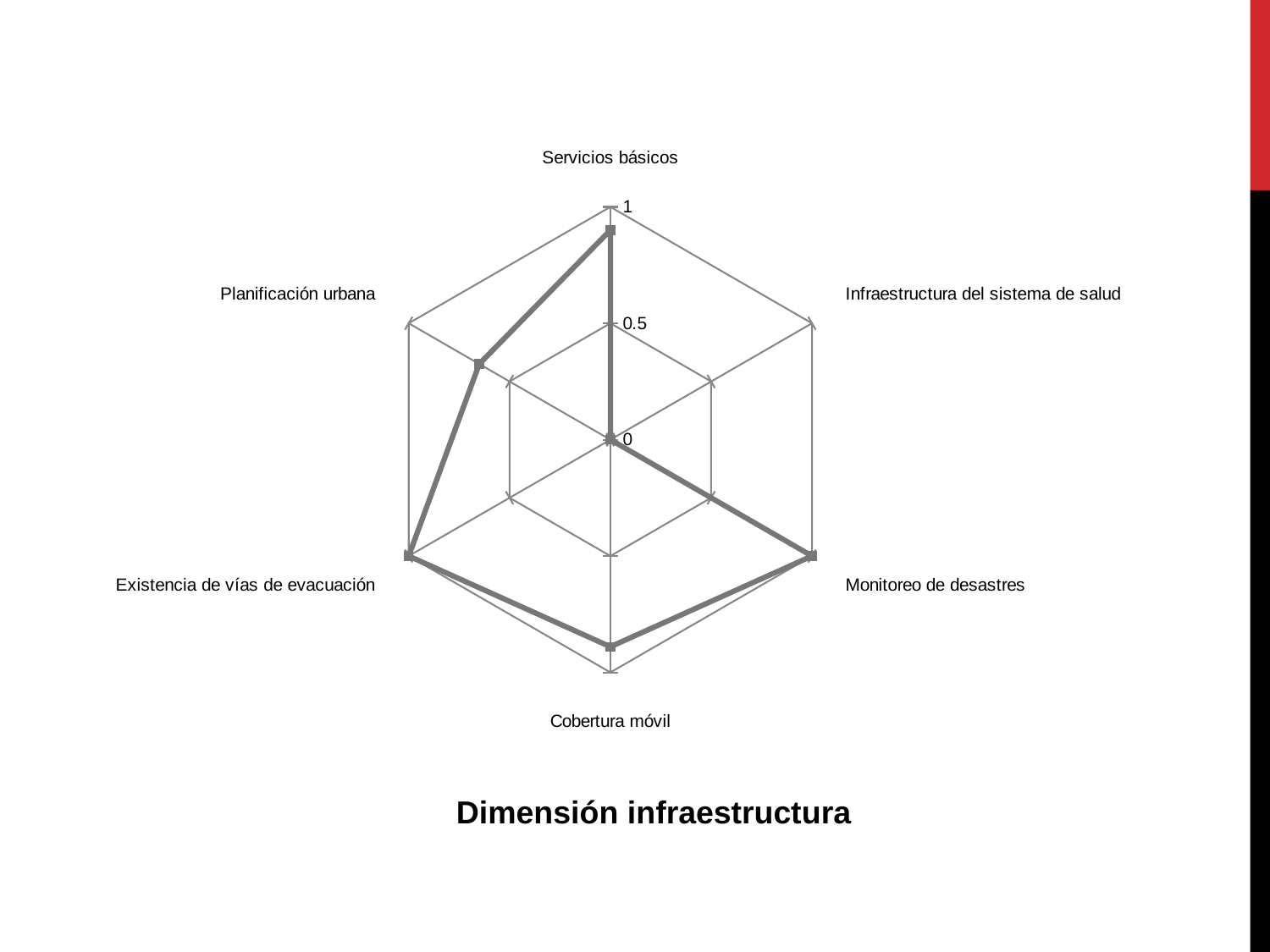
How many categories (axes) does the radar chart have? 6 What is the value for Existencia de vías de evacuación? 1 What is the title shown below the chart? Dimensión infraestructura Which is larger, the value for Cobertura móvil or the value for Planificación urbana? Cobertura móvil Which category has the lowest value? Infraestructura del sistema de salud Is the value for Servicios básicos greater or less than 0.5? greater Is the value for Cobertura móvil greater or less than 0.5? greater Is the value for Planificación urbana greater or less than 0.5? greater Which is larger, the value for Servicios básicos or the value for Infraestructura del sistema de salud? Servicios básicos What kind of chart is shown on the slide? Radar chart What is the value for Monitoreo de desastres? 1 What is the value for Infraestructura del sistema de salud? 0